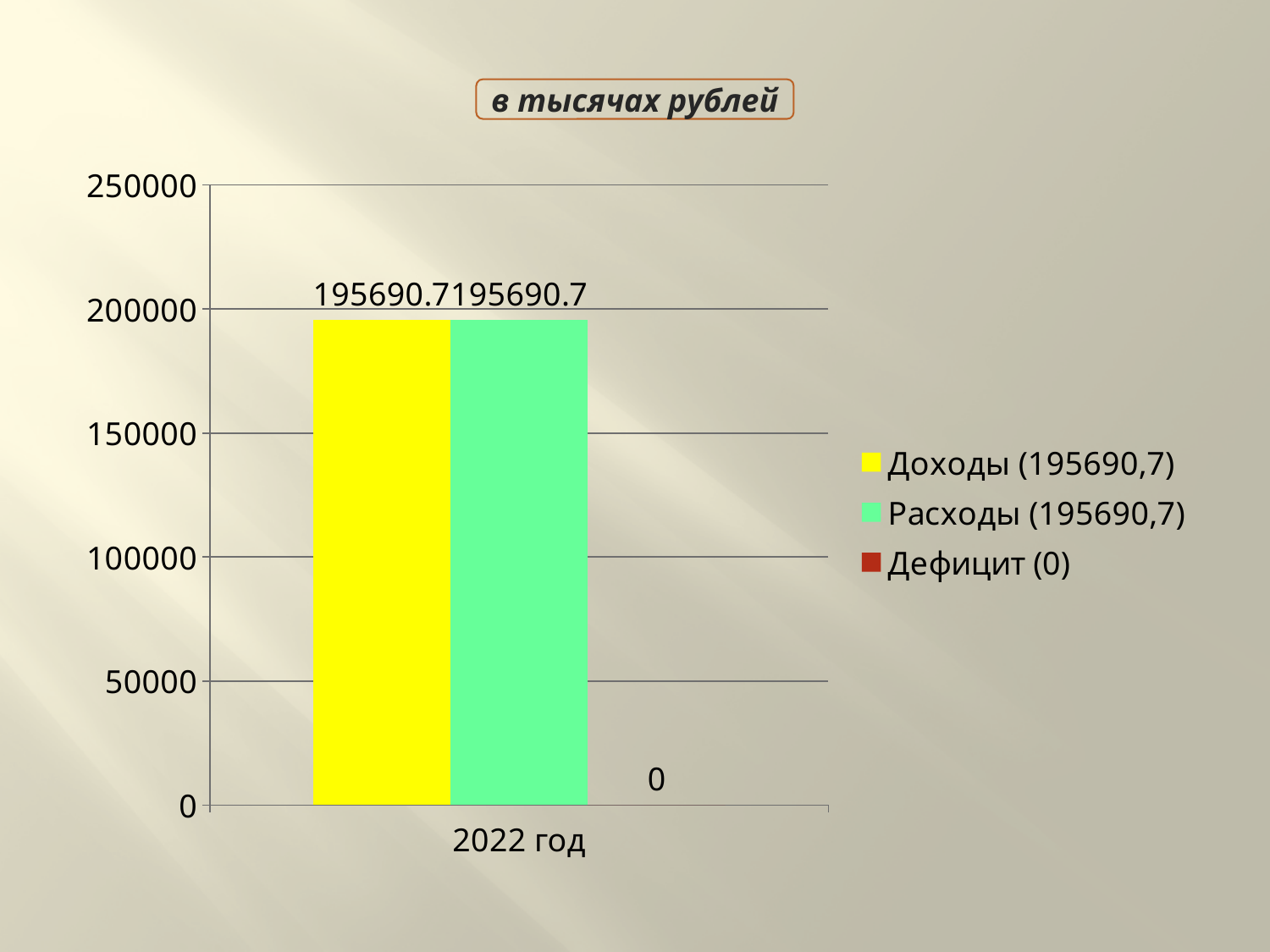
What is the value of Доходы for 2022 год? 195690.7 Is the value for Доходы in 2022 год greater or less than 200000? less What kind of chart is shown on the slide? bar chart What is the difference between Доходы and Расходы for 2022 год? 0 Which series has the lowest value for 2022 год? Дефицит How many categories are shown on the x axis? 1 How many series does the legend list? 3 What colour is the bar for Расходы? green What is the title shown above the chart? в тысячах рублей Is the value for Расходы in 2022 год greater or less than 150000? greater What is the value of Расходы for 2022 год? 195690.7 What is the value of Дефицит for 2022 год? 0